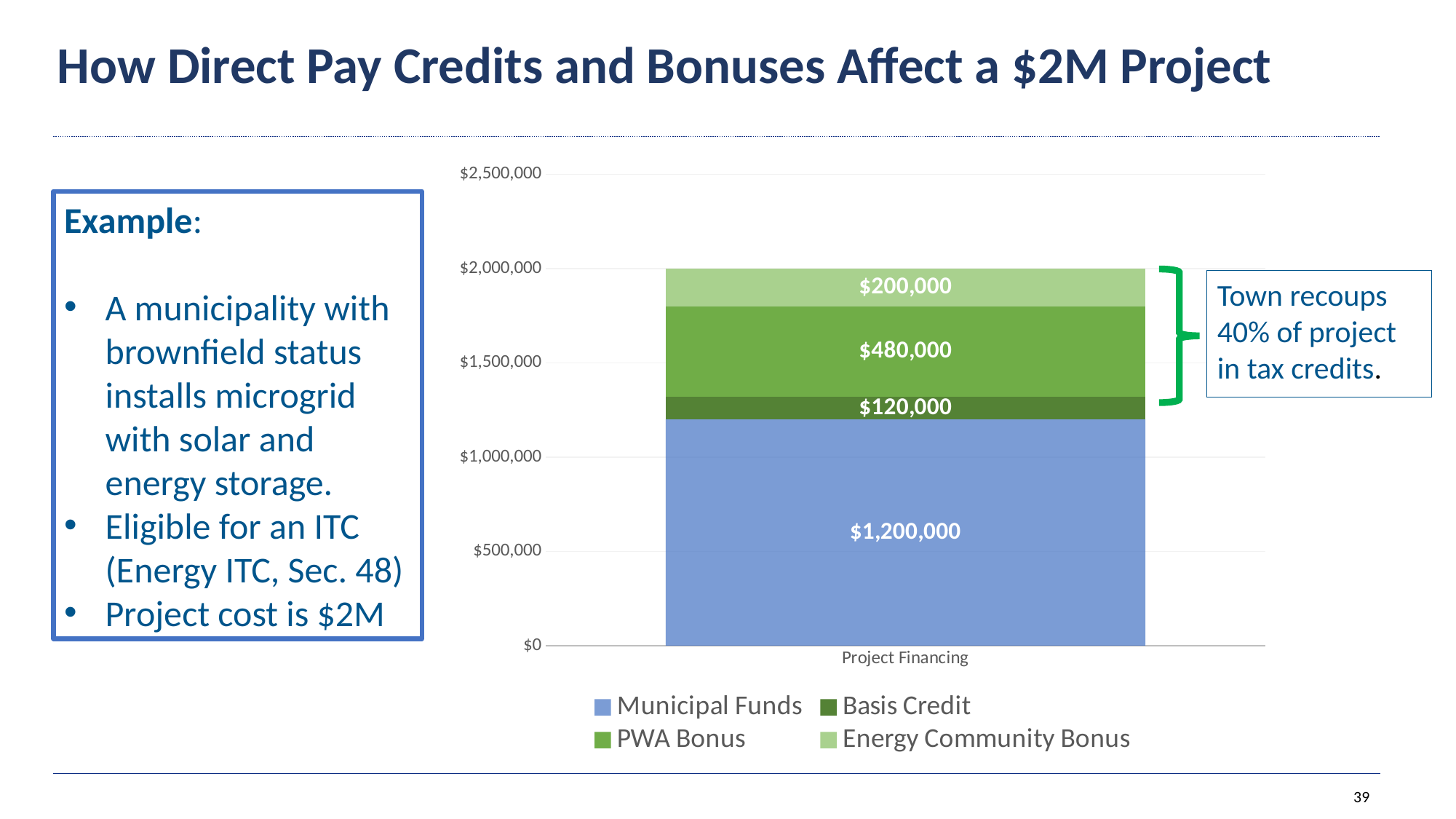
Which series has the largest value in the stacked bar? Municipal Funds What is the total of the Project Financing stacked bar? $2,000,000 What is the value of Municipal Funds in the Project Financing bar? $1,200,000 What is the category label on the x axis of the chart? Project Financing How many series does the legend list? 4 What kind of chart is shown on the slide? Stacked bar chart What is the value of the PWA Bonus segment? $480,000 Which series has the smallest value in the stacked bar? Basis Credit What is the value of the Energy Community Bonus segment? $200,000 Which is larger, the PWA Bonus or the Basis Credit? PWA Bonus What is the value of the Basis Credit segment? $120,000 What is the difference between the PWA Bonus and the Energy Community Bonus? $280,000